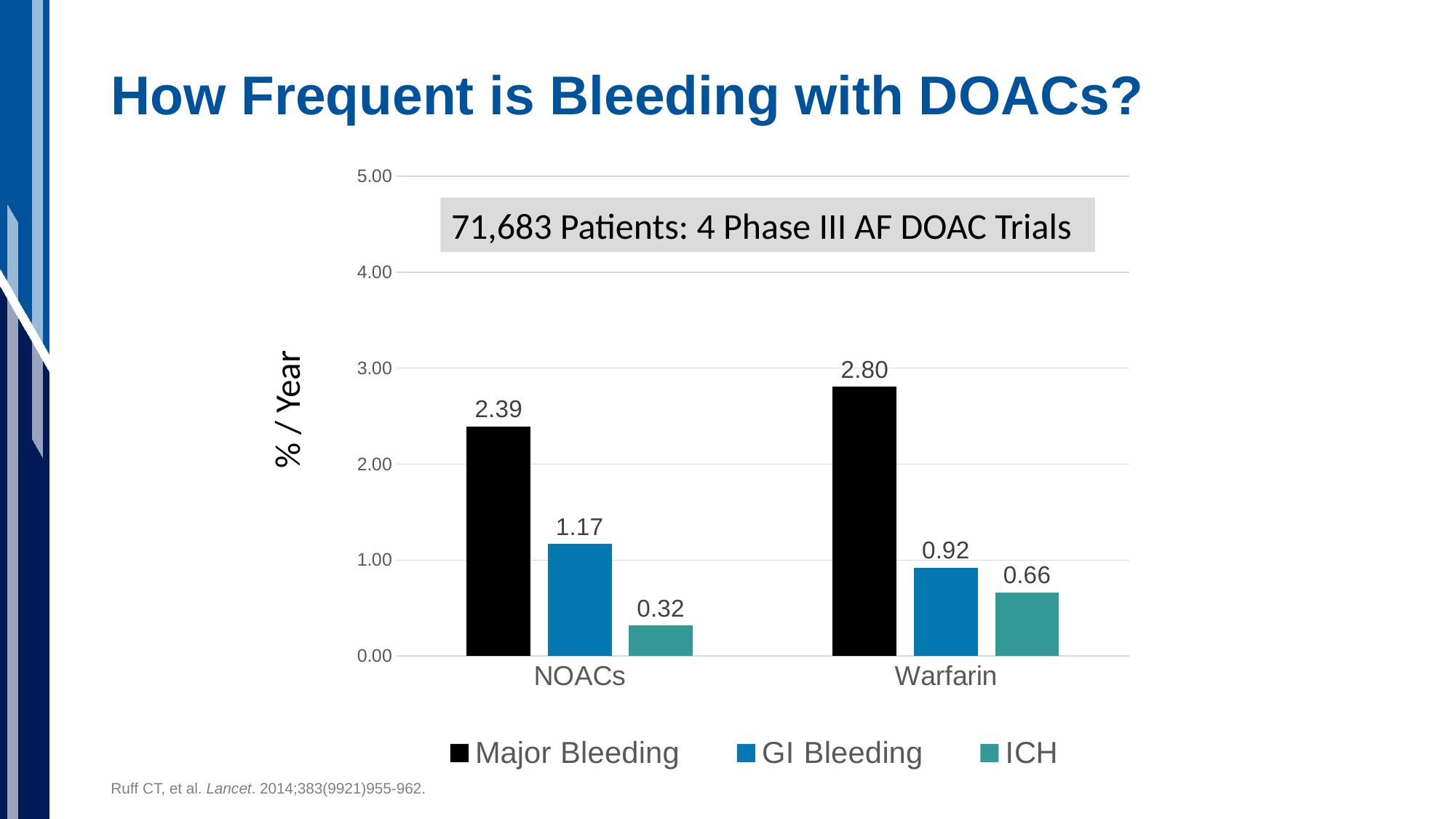
What is the ICH rate (% / Year) for NOACs? 0.32 What is the GI Bleeding rate (% / Year) for Warfarin? 0.92 What is the difference between the ICH rates for Warfarin and NOACs? 0.34 Which series has the lowest value for Warfarin? ICH What is the label on the y axis of the chart? % / Year What kind of chart is shown on the slide? Bar chart Which is larger, the GI Bleeding rate for NOACs or for Warfarin? NOACs Is the Major Bleeding value for Warfarin greater or less than 3.00? less How many series does the legend list? 3 What is the difference between the Major Bleeding rates for Warfarin and NOACs? 0.41 What is the Major Bleeding rate (% / Year) for NOACs? 2.39 Which category has the highest Major Bleeding rate, NOACs or Warfarin? Warfarin